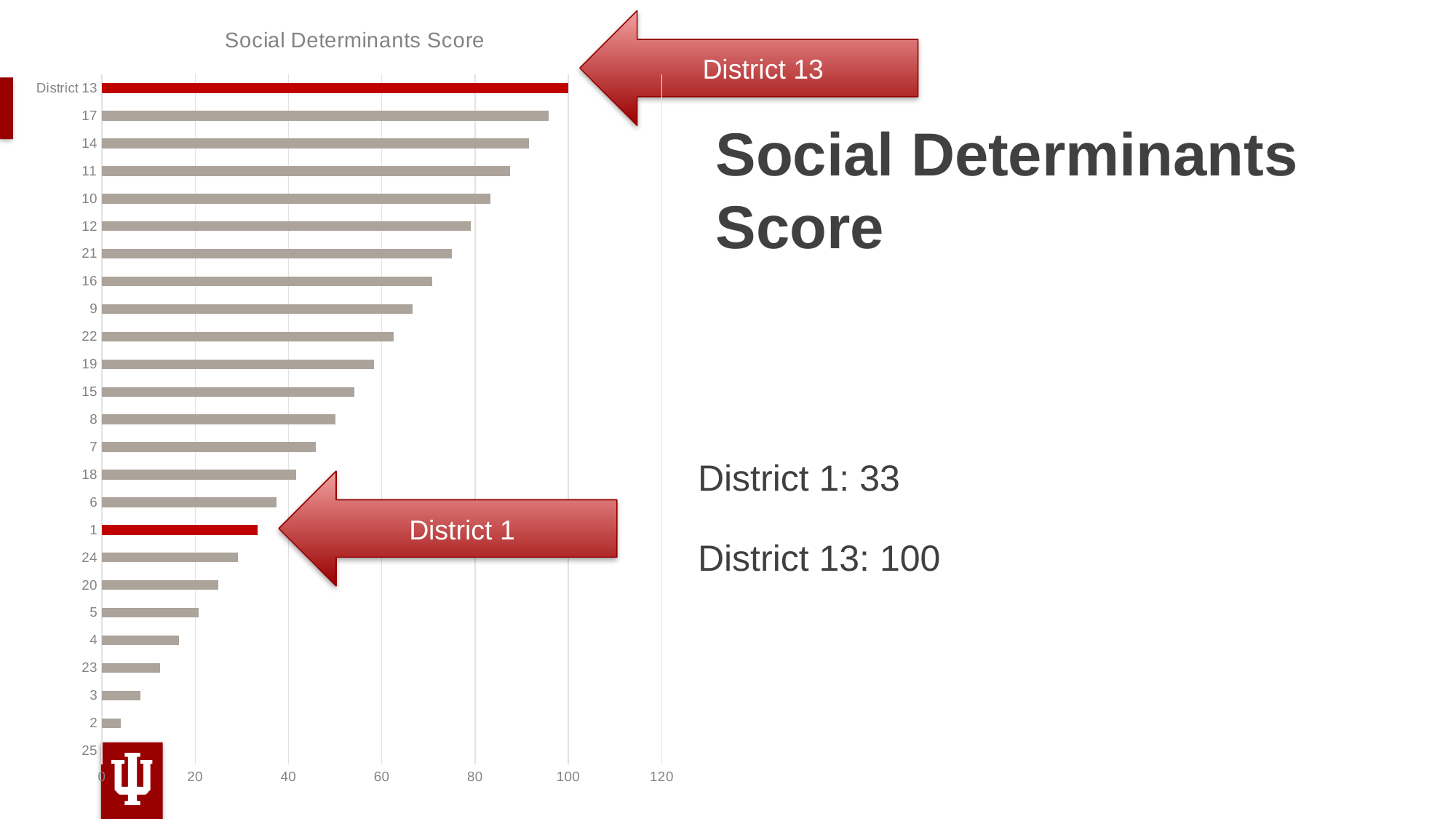
How many districts are shown in the chart? 25 Is the value for District 17 greater or less than 80? greater Which has a higher Social Determinants Score, District 8 or District 7? District 8 What is the difference between the scores of District 13 and District 1? 67 Is the value for District 24 greater or less than 40? less What colour is the bar for District 13? Red Is the value for District 16 greater or less than 60? greater What is the Social Determinants Score for District 13? 100 Which has a higher Social Determinants Score, District 17 or District 14? District 17 What is the Social Determinants Score for District 1? 33 Which district has the highest Social Determinants Score? District 13 What type of chart is shown on the slide? Bar chart